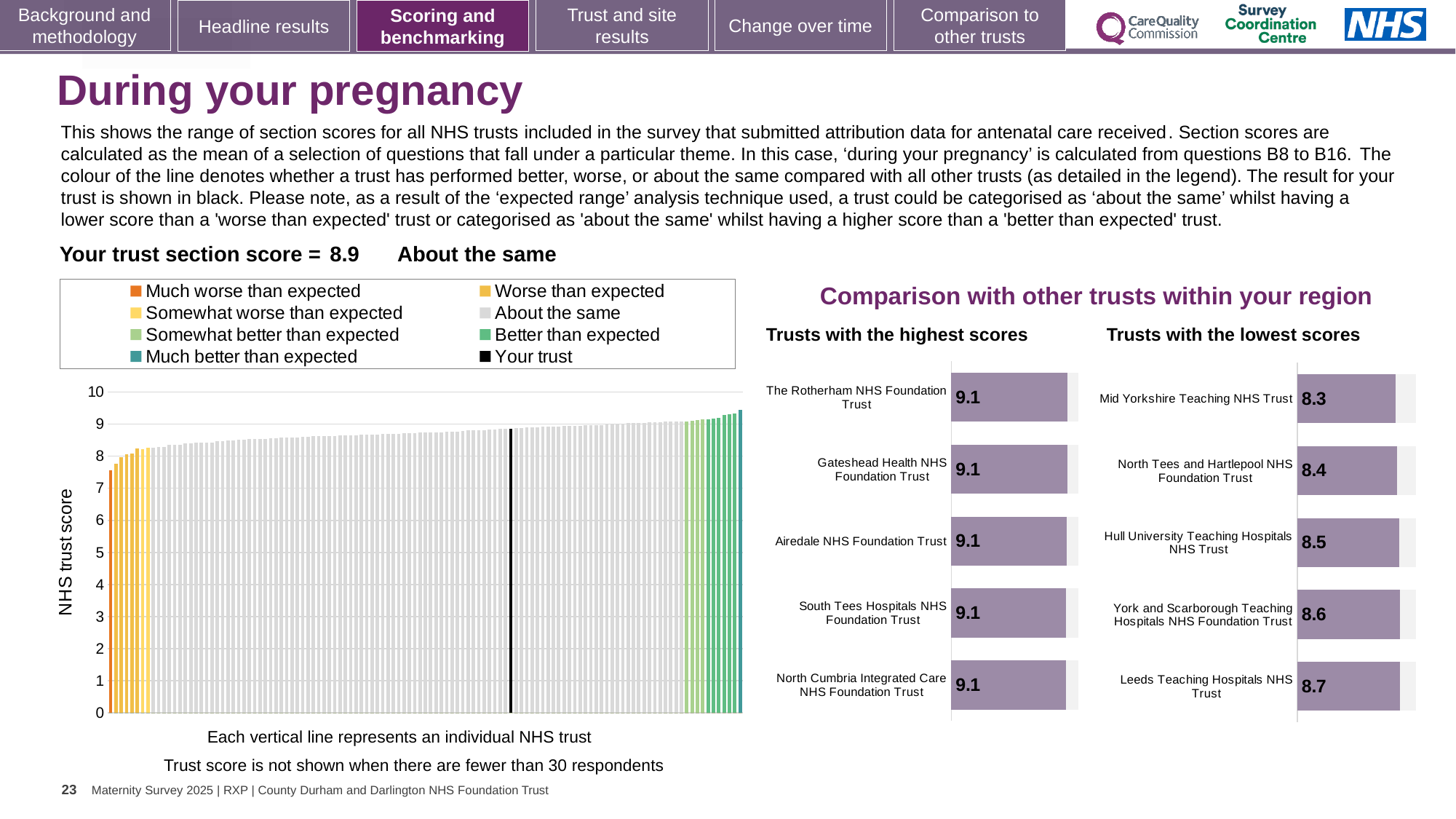
In the 'Trusts with the lowest scores' chart, which trust has the highest score? Leeds Teaching Hospitals NHS Trust In the 'Trusts with the highest scores' chart, what is the score for Airedale NHS Foundation Trust? 9.1 In the main 'NHS trust score' chart, is the value of the leftmost (orange) bar greater or less than 8? less In the main 'NHS trust score' chart, do the values rise or fall from left to right? Rise How many entries does the legend of the main 'NHS trust score' chart list? 8 In the 'Trusts with the lowest scores' chart, what is the score for Leeds Teaching Hospitals NHS Trust? 8.7 In the 'Trusts with the lowest scores' chart, which trust has the lowest score? Mid Yorkshire Teaching NHS Trust In the 'Trusts with the lowest scores' chart, what is the difference between the scores of Leeds Teaching Hospitals NHS Trust and Mid Yorkshire Teaching NHS Trust? 0.4 In the 'Trusts with the lowest scores' chart, which has the larger score: Hull University Teaching Hospitals NHS Trust or North Tees and Hartlepool NHS Foundation Trust? Hull University Teaching Hospitals NHS Trust How many trusts are shown in the 'Trusts with the highest scores' chart? 5 In the 'Trusts with the lowest scores' chart, what is the score for Mid Yorkshire Teaching NHS Trust? 8.3 What kind of chart is the main chart on the left with the 'NHS trust score' axis? Bar chart